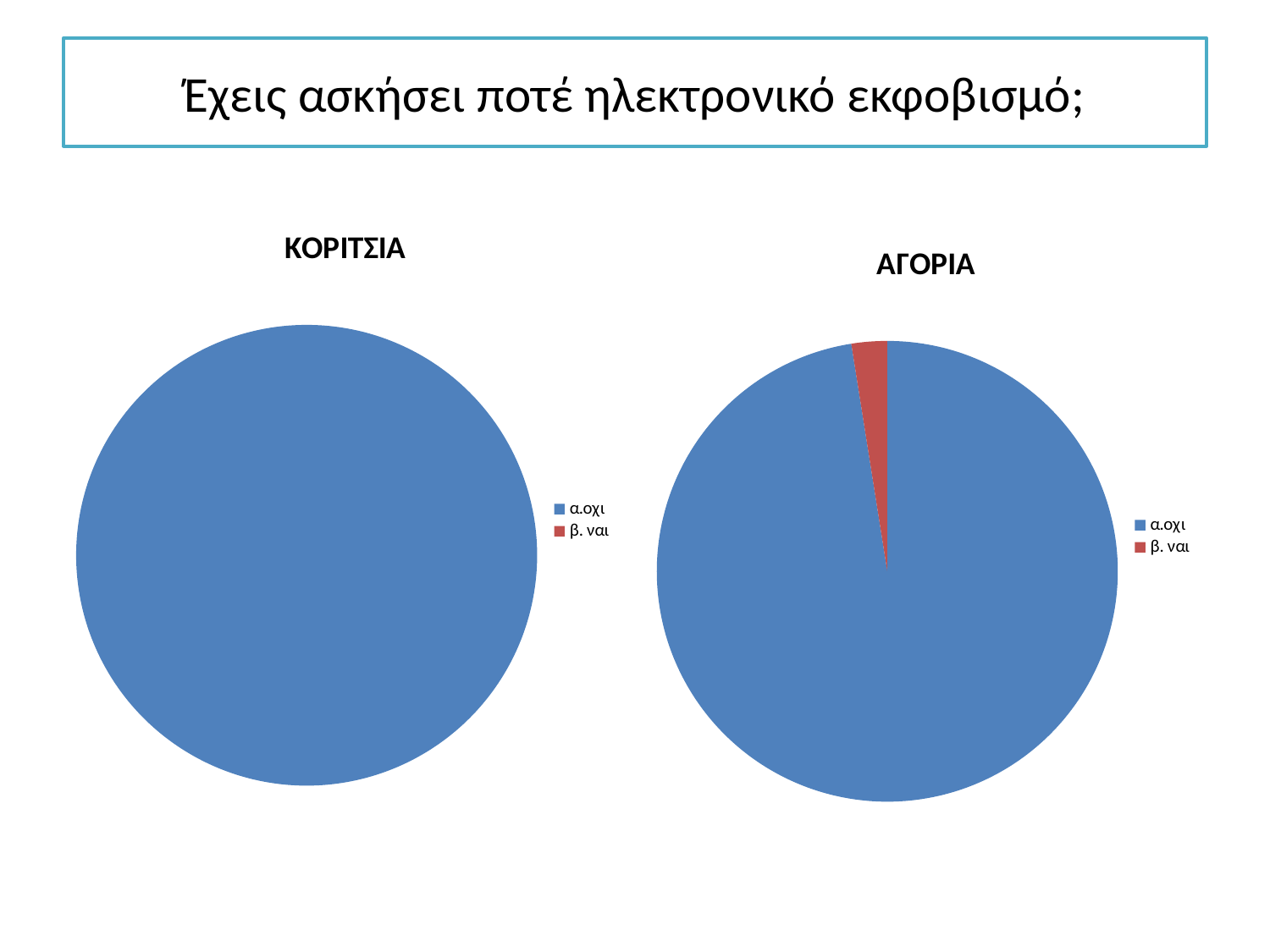
In the ΑΓΟΡΙΑ chart, what colour is the β. ναι slice? red How many entries does the legend of the ΑΓΟΡΙΑ chart list? 2 In the ΑΓΟΡΙΑ chart, which category has the largest slice? α.οχι In the ΚΟΡΙΤΣΙΑ chart, which category has the largest slice? α.οχι In the ΑΓΟΡΙΑ chart, which slice is larger, α.οχι or β. ναι? α.οχι How many pie charts are shown on the slide? 2 In the ΑΓΟΡΙΑ chart, which category has the smallest slice? β. ναι How many entries does the legend of the ΚΟΡΙΤΣΙΑ chart list? 2 What kind of chart is the ΚΟΡΙΤΣΙΑ chart? pie chart What is the title of the chart on the left? ΚΟΡΙΤΣΙΑ What kind of chart is the ΑΓΟΡΙΑ chart? pie chart